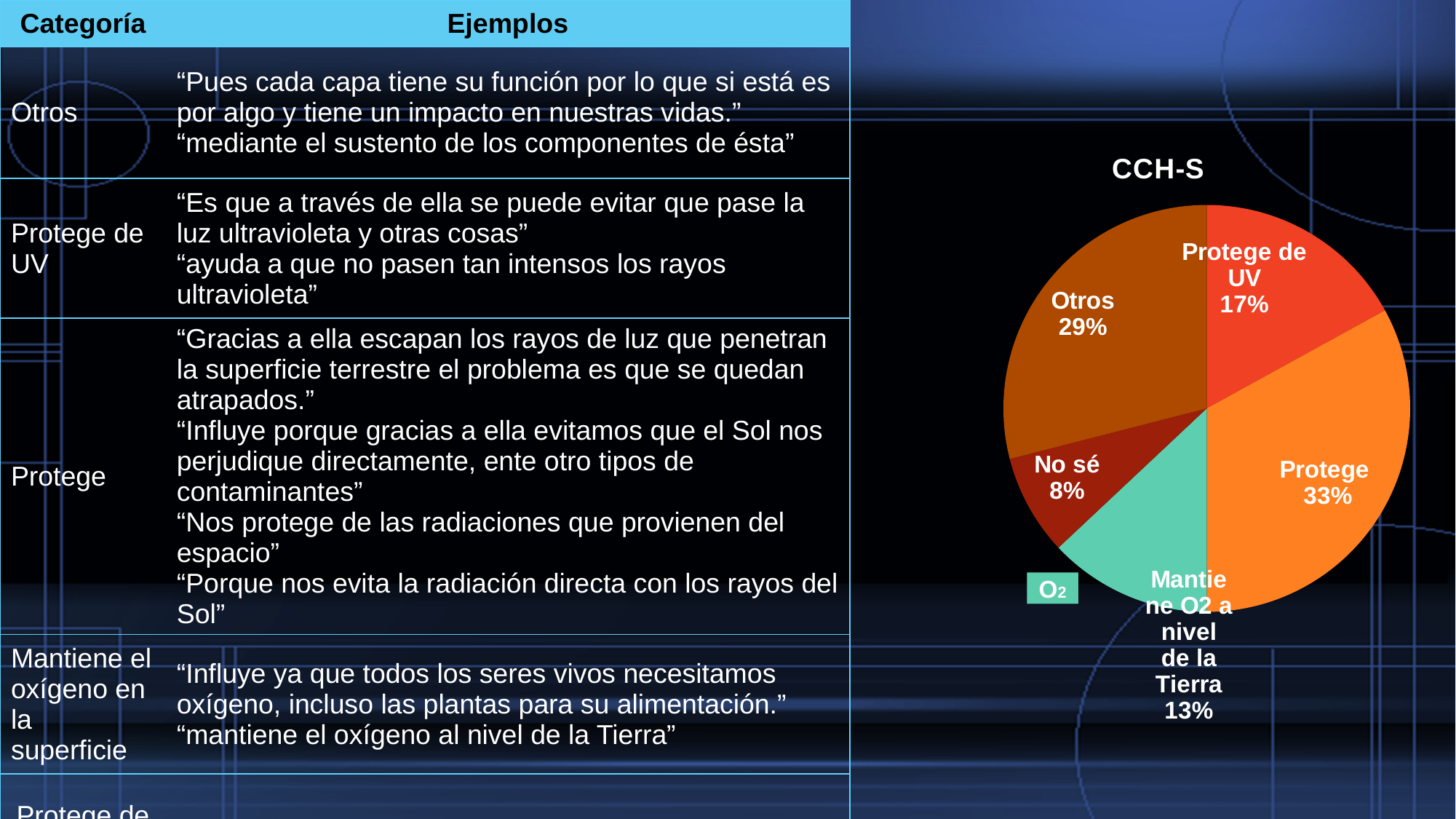
What is the title of the chart? CCH-S What percentage is shown for 'Protege de UV'? 17% Which category has the largest share of the pie? Protege What is the difference in percentage points between 'Protege' and 'Otros'? 4 What percentage is shown for 'No sé'? 8% How many slices does the pie chart have? 5 What percentage is shown for the 'Otros' slice? 29% Which category has the smallest share of the pie? No sé What percentage of the pie does the 'Protege' slice represent? 33% Which is larger, the share for 'Protege de UV' or the share for 'Mantiene O2 a nivel de la Tierra'? Protege de UV What percentage is shown for 'Mantiene O2 a nivel de la Tierra'? 13% What type of chart is shown on the slide? pie chart